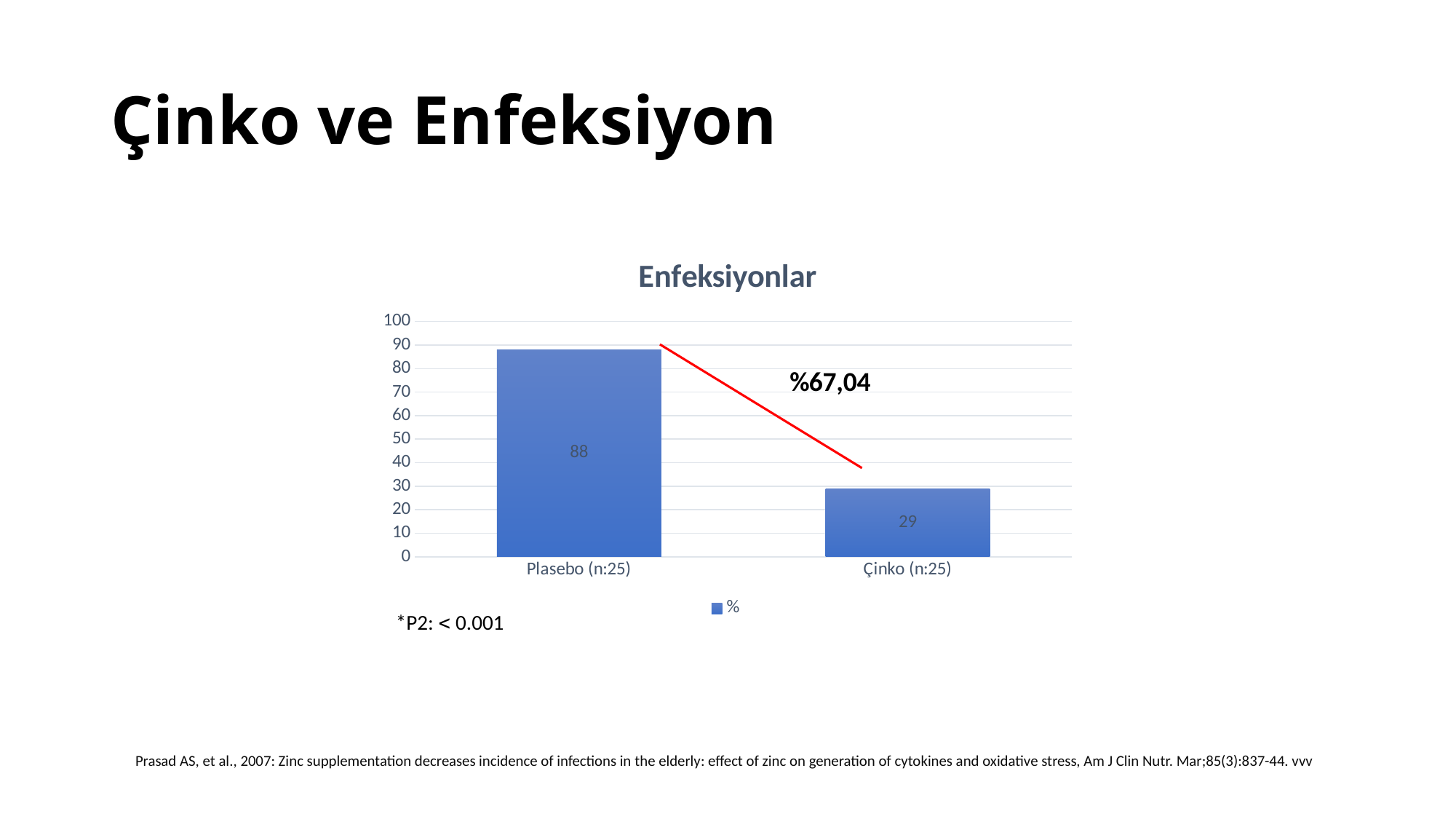
Which category has the lowest value? Çinko (n:25) What kind of chart is shown? bar chart Is the value for Çinko (n:25) greater or less than 50? less What is the value for Plasebo (n:25)? 88 Which category has the highest value? Plasebo (n:25) How many series does the legend list? 1 What is the value for Çinko (n:25)? 29 What is the difference between the values for Plasebo (n:25) and Çinko (n:25)? 59 What percentage reduction is annotated next to the red line on the chart? %67,04 What is the title of the chart? Enfeksiyonlar How many categories are shown on the x axis? 2 Which is larger, the value for Plasebo (n:25) or the value for Çinko (n:25)? Plasebo (n:25)